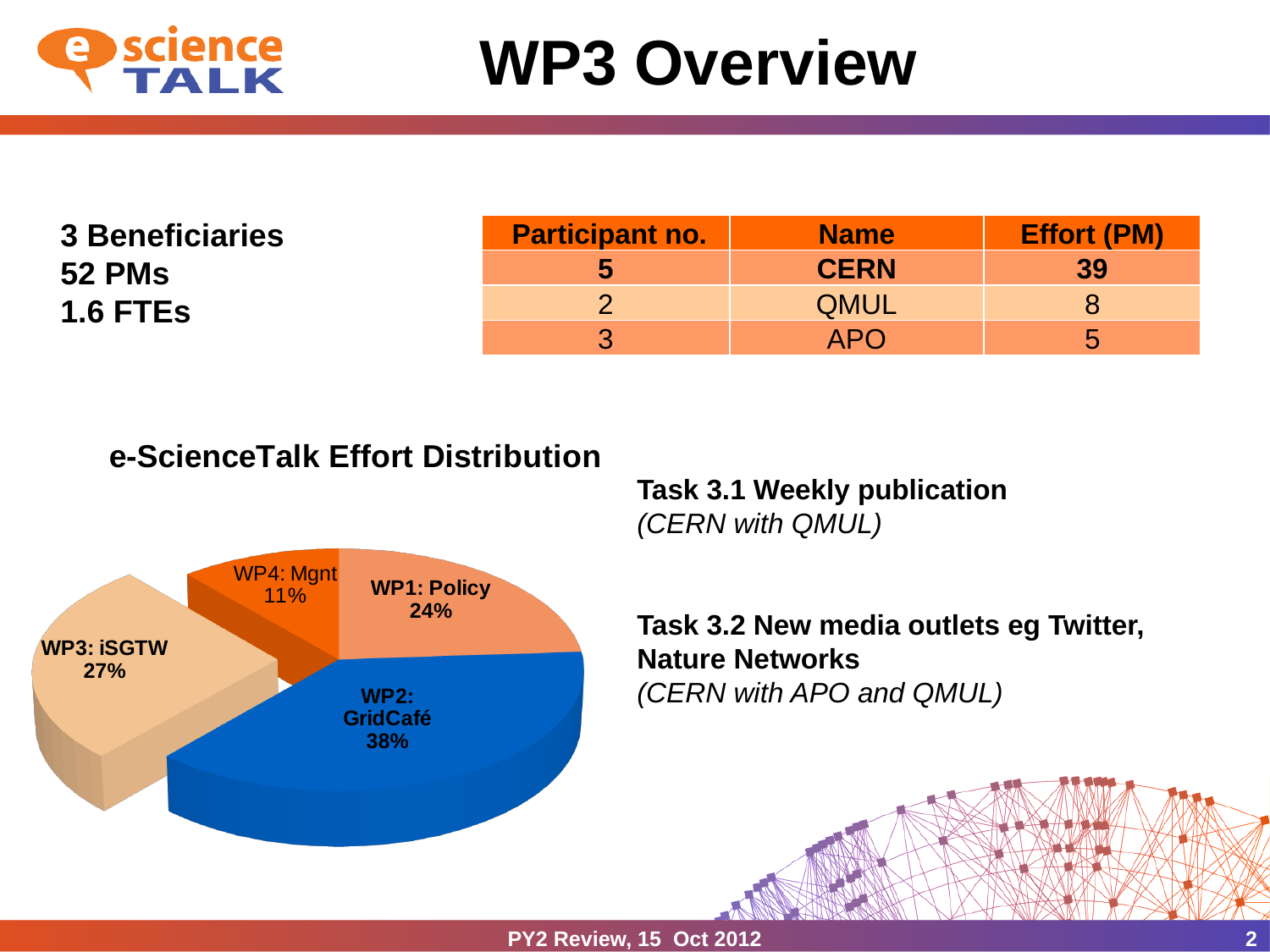
Which slice of the e-ScienceTalk Effort Distribution pie chart is the smallest? WP4: Mgnt What is the title of the pie chart on the slide? e-ScienceTalk Effort Distribution In the e-ScienceTalk Effort Distribution pie chart, which has a larger share: WP3: iSGTW or WP1: Policy? WP3: iSGTW Which slice of the e-ScienceTalk Effort Distribution pie chart is the largest? WP2: GridCafé What is the percentage shown for WP1: Policy in the e-ScienceTalk Effort Distribution pie chart? 24% What colour is the WP2: GridCafé slice in the e-ScienceTalk Effort Distribution pie chart? Blue What is the percentage shown for WP4: Mgnt in the e-ScienceTalk Effort Distribution pie chart? 11% What type of chart is the e-ScienceTalk Effort Distribution chart? Pie chart How many slices does the e-ScienceTalk Effort Distribution pie chart have? 4 What share of the e-ScienceTalk Effort Distribution pie chart does WP3: iSGTW account for? 27% In the e-ScienceTalk Effort Distribution pie chart, what is the difference in percentage points between WP2: GridCafé and WP4: Mgnt? 27 What share of the e-ScienceTalk Effort Distribution pie chart does WP2: GridCafé account for? 38%